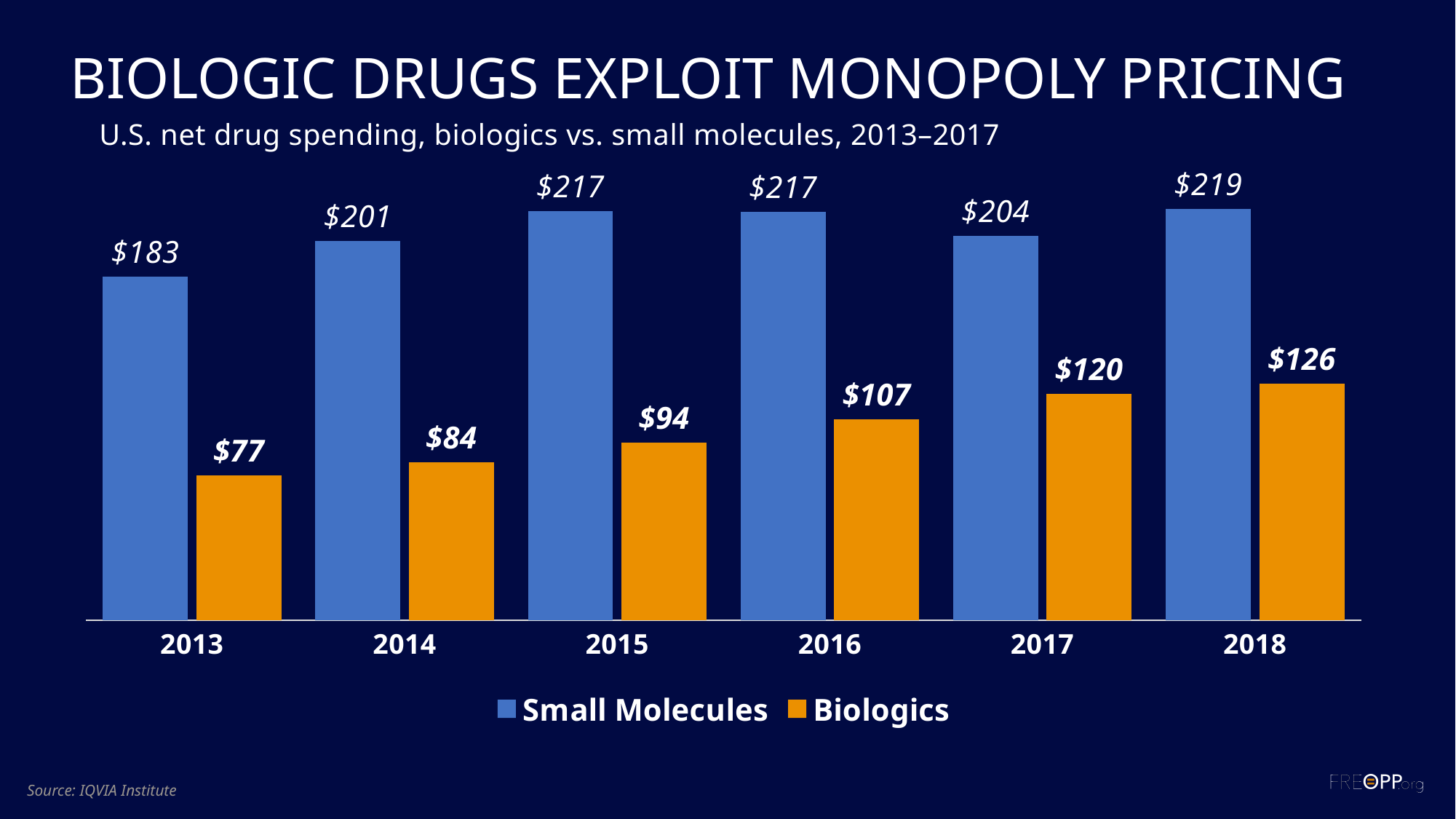
How many years are shown on the x axis? 6 What kind of chart is shown on the slide? Bar chart How many series does the legend list? 2 What is the difference between Small Molecules and Biologics in 2016? $110 Which year has the lowest value for Biologics? 2013 What is the value for Small Molecules in 2013? $183 Do the Biologics values rise or fall from 2013 to 2018? Rise What is the value for Biologics in 2018? $126 Which is larger in 2017, Small Molecules or Biologics? Small Molecules Which year has the highest value for Small Molecules? 2018 What is the value for Biologics in 2015? $94 What is the difference between the Biologics values for 2018 and 2013? $49